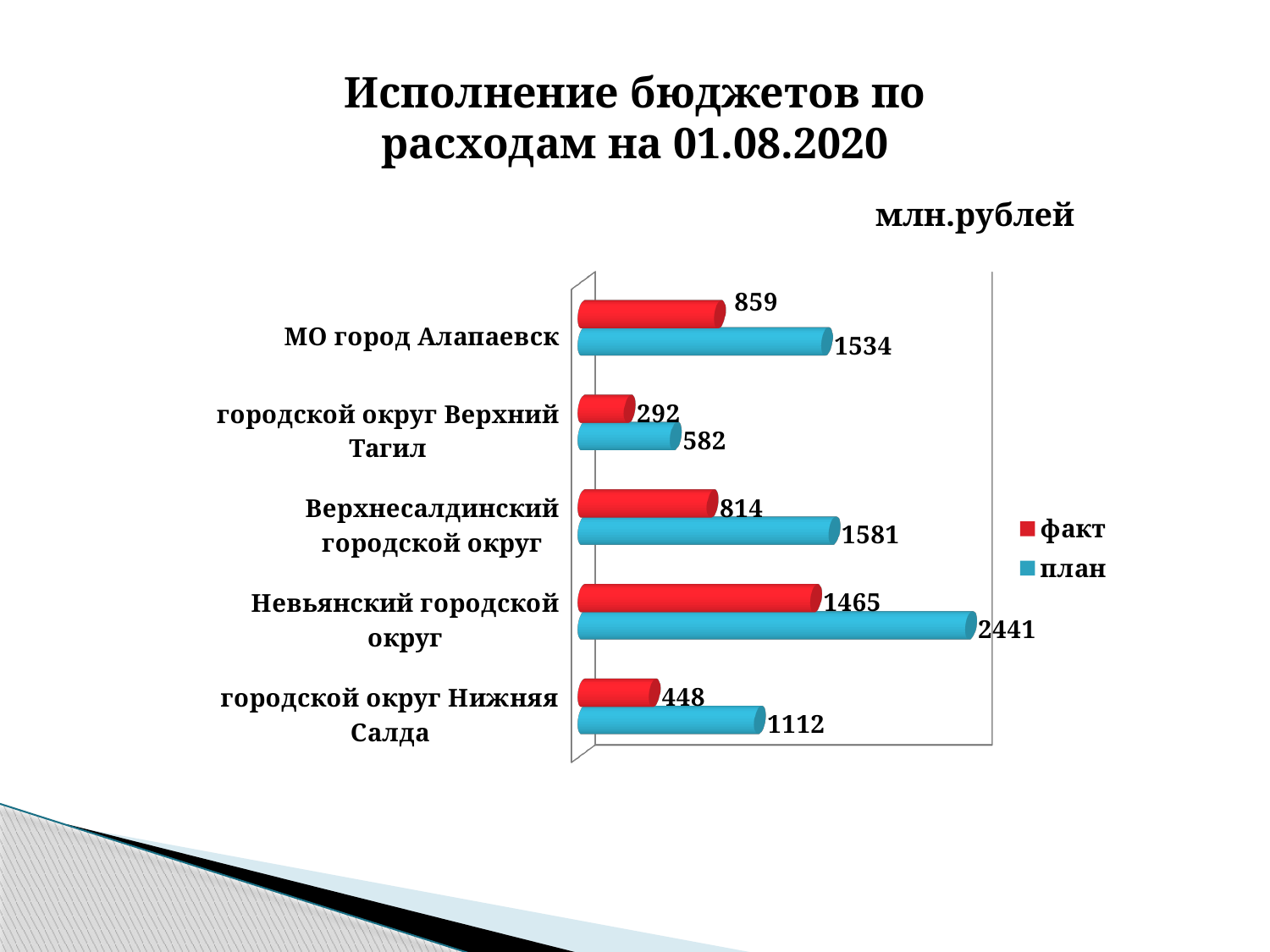
Which category has the lowest факт value? городской округ Верхний Тагил Which is larger: the факт value for МО город Алапаевск or the факт value for Верхнесалдинский городской округ? МО город Алапаевск What is the план value for городской округ Верхний Тагил? 582 What is the факт value for МО город Алапаевск? 859 Which category has the highest план value? Невьянский городской округ What is the difference between план and факт for городской округ Нижняя Салда? 664 What unit is indicated above the chart? млн.рублей What is the план value for Невьянский городской округ? 2441 What is the difference between план and факт for Верхнесалдинский городской округ? 767 How many categories are shown on the chart? 5 How many series does the legend list? 2 What kind of chart is shown on the slide? bar chart